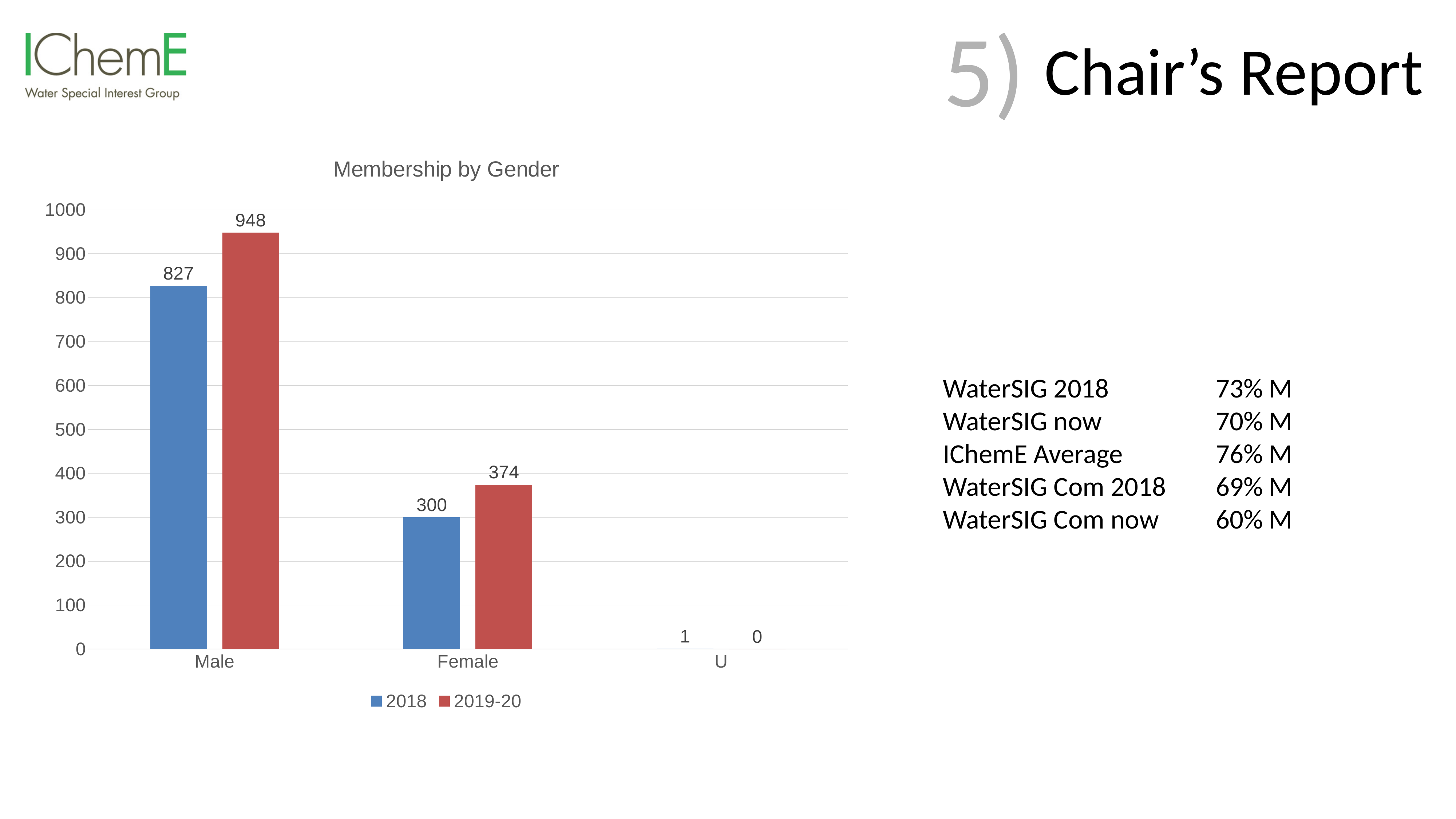
How many series does the legend of the Membership by Gender chart list? 2 What is the 2018 value for U in the Membership by Gender chart? 1 What kind of chart is the Membership by Gender chart? bar chart What is the difference between the 2019-20 and 2018 values for Male in the Membership by Gender chart? 121 Is the 2019-20 value for Female greater or less than 400 in the Membership by Gender chart? less How many categories are shown on the x axis of the Membership by Gender chart? 3 What is the difference between the 2019-20 and 2018 values for Female in the Membership by Gender chart? 74 Which category has the lowest 2018 value in the Membership by Gender chart? U What is the 2019-20 value for Male in the Membership by Gender chart? 948 Which is larger in the Membership by Gender chart: the 2018 value for Male or the 2019-20 value for Female? 2018 value for Male Which category has the highest 2019-20 value in the Membership by Gender chart? Male What is the 2018 value for Female in the Membership by Gender chart? 300